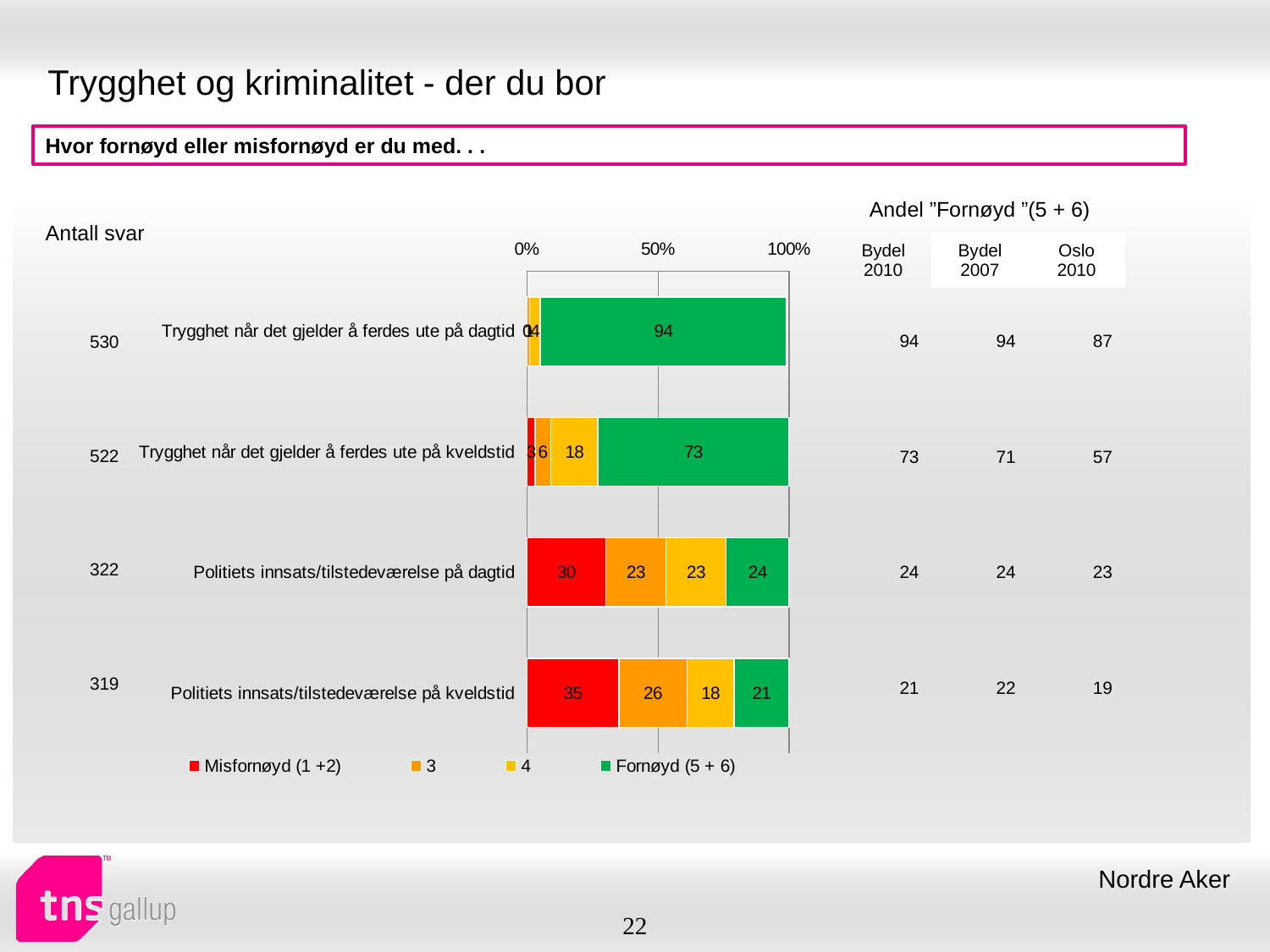
What is the Fornøyd (5 + 6) value for "Trygghet når det gjelder å ferdes ute på kveldstid"? 73 What is the total of the stacked bar for "Politiets innsats/tilstedeværelse på dagtid"? 100 Which is larger: the Fornøyd (5 + 6) value for "Politiets innsats/tilstedeværelse på dagtid" or for "Politiets innsats/tilstedeværelse på kveldstid"? Politiets innsats/tilstedeværelse på dagtid What is the value of series 3 for "Politiets innsats/tilstedeværelse på dagtid"? 23 How many series does the legend list? 4 What is the Misfornøyd (1 +2) value for "Politiets innsats/tilstedeværelse på kveldstid"? 35 What is the Fornøyd (5 + 6) value for "Trygghet når det gjelder å ferdes ute på dagtid"? 94 Which category has the lowest Fornøyd (5 + 6) value? Politiets innsats/tilstedeværelse på kveldstid How many categories are plotted in the bar chart? 4 Which category has the highest Fornøyd (5 + 6) value? Trygghet når det gjelder å ferdes ute på dagtid What kind of chart is shown on the slide? stacked bar chart What is the difference between the Misfornøyd (1 +2) values for "Politiets innsats/tilstedeværelse på kveldstid" and "Politiets innsats/tilstedeværelse på dagtid"? 5